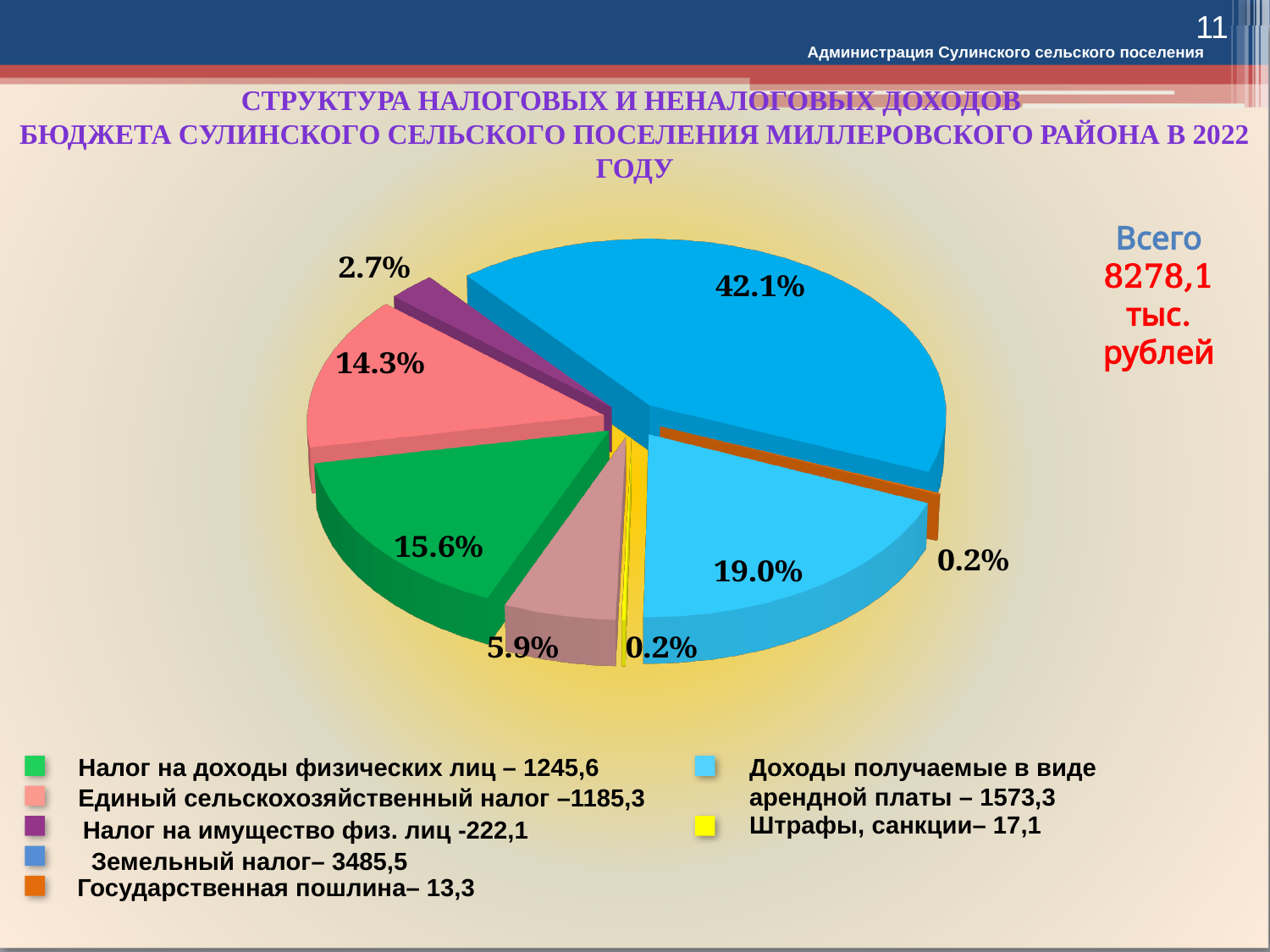
What is the largest percentage shown on the pie chart? 42.1% What total (Всего) is stated next to the chart? 8278,1 тыс. рублей What is the difference in percentage points between the 42.1% slice and the 19.0% slice? 23.1 What kind of chart is shown on the slide? pie chart How many slices does the pie chart have? 8 What is the smallest percentage shown on the pie chart? 0.2% According to the legend, what is the value for Земельный налог? 3485,5 What share of the pie does the dark blue slice (Земельный налог) take? 42.1% Which slice is larger: the green one (15.6%) or the pink one (14.3%)? the green one (15.6%) How many entries does the legend below the chart list? 7 According to the legend, what is the value for Штрафы, санкции? 17,1 What share of the pie does the light blue slice (Доходы получаемые в виде арендной платы) take? 19.0%